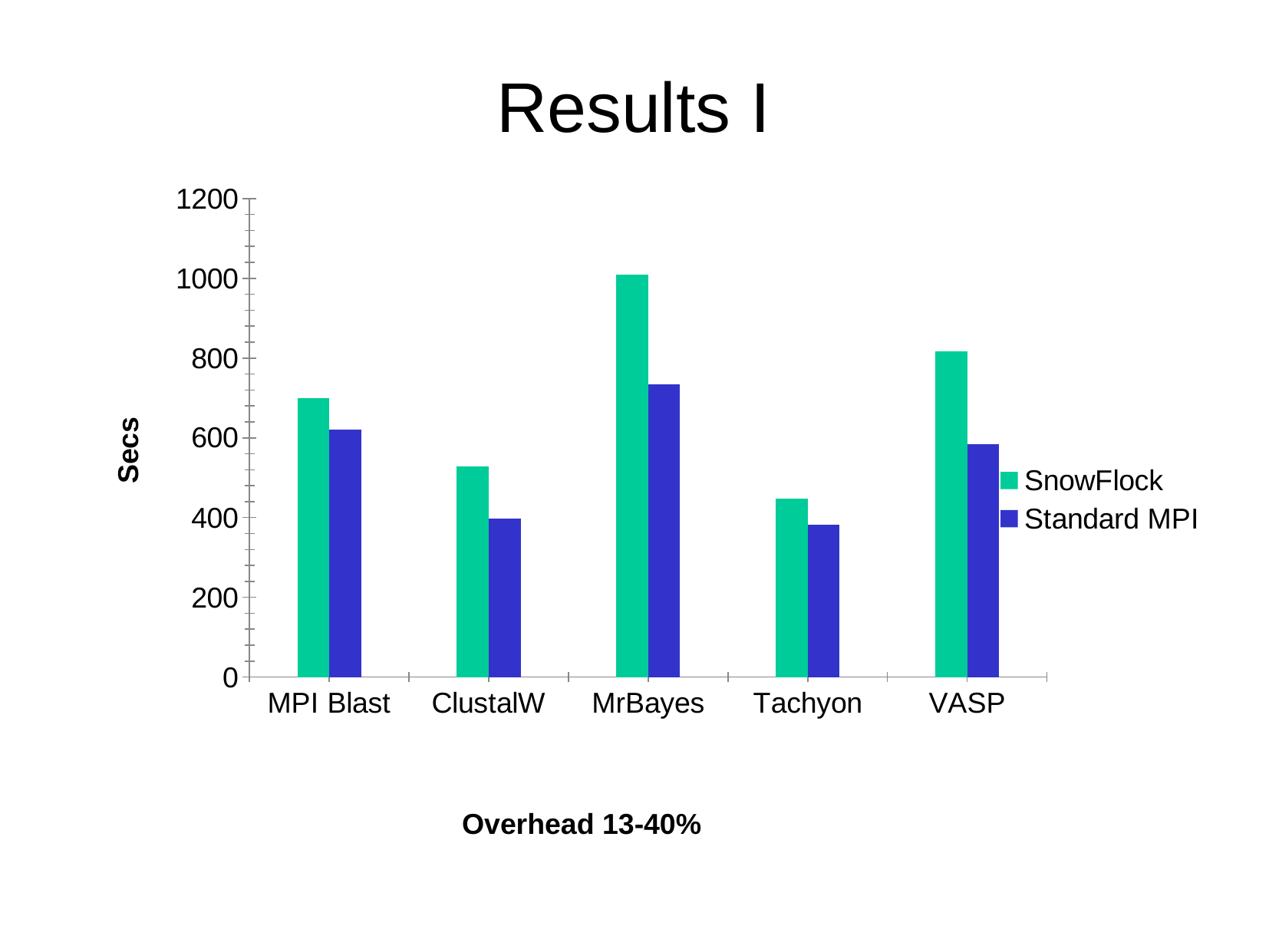
Which is larger: the SnowFlock value for VASP or the SnowFlock value for MPI Blast? VASP What kind of chart is shown on the slide? bar chart Is the SnowFlock value for MrBayes greater or less than 800? greater Which application has the lowest Standard MPI value? Tachyon For ClustalW, which is larger: the SnowFlock value or the Standard MPI value? SnowFlock How many series does the legend list? 2 Which application has the highest SnowFlock value? MrBayes How many application categories are shown on the x axis? 5 What is the label on the y axis? Secs Is the SnowFlock value for Tachyon greater or less than 600? less Which application has the lowest SnowFlock value? Tachyon Is the Standard MPI value for VASP greater or less than 400? greater